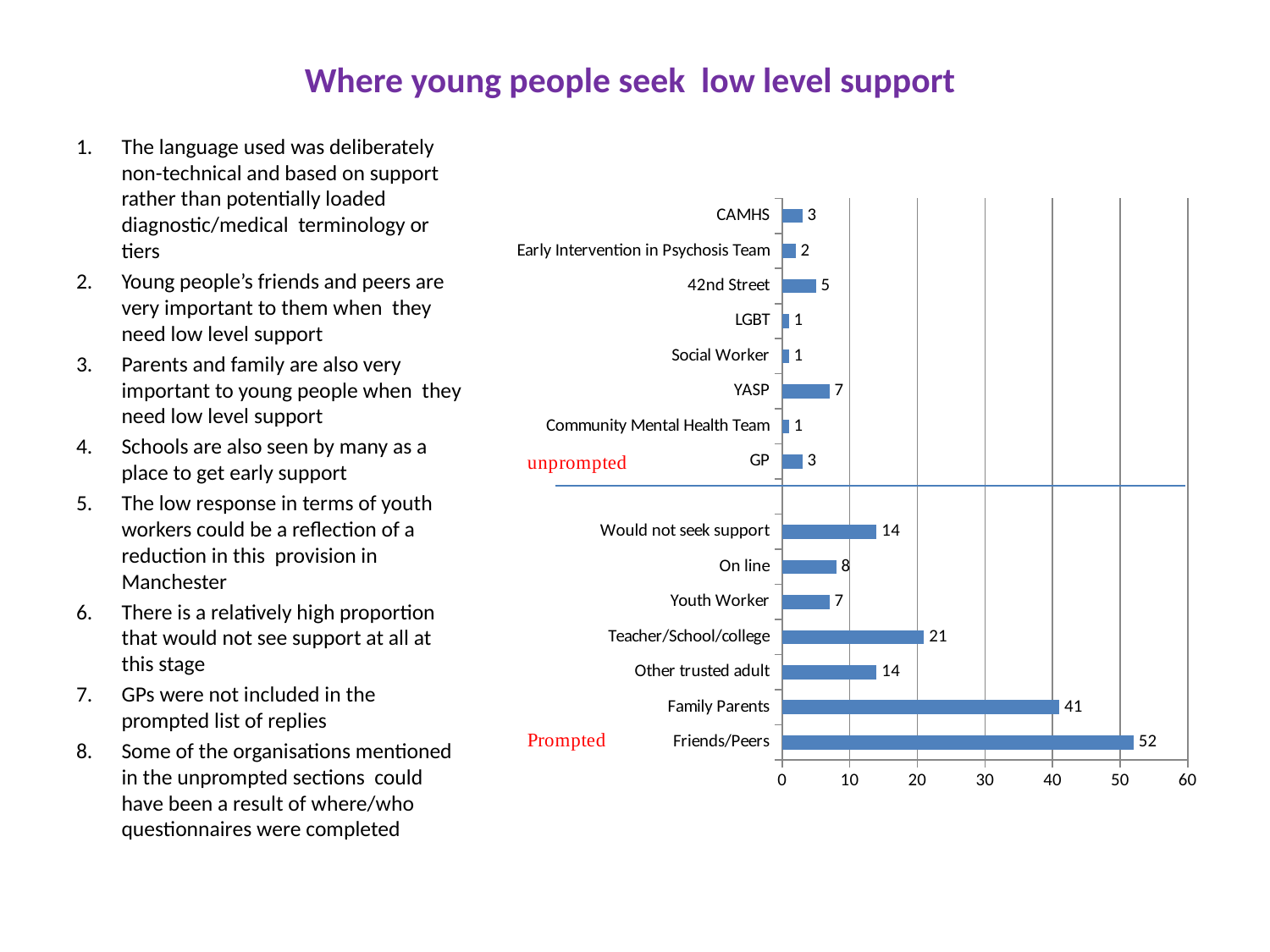
What value is shown for Friends/Peers? 52 What value is shown for Teacher/School/college? 21 Is the value for Family Parents greater or less than 40? greater What kind of chart is shown on the slide? bar chart How many categories are listed in the prompted section of the chart? 7 Which category has the highest value? Friends/Peers Which is larger, the value for On line or the value for Youth Worker? On line How many categories are listed in the unprompted section of the chart? 8 What value is shown for YASP? 7 What value is shown for Would not seek support? 14 What is the difference between the values for Friends/Peers and Family Parents? 11 What is the maximum value shown on the horizontal axis? 60